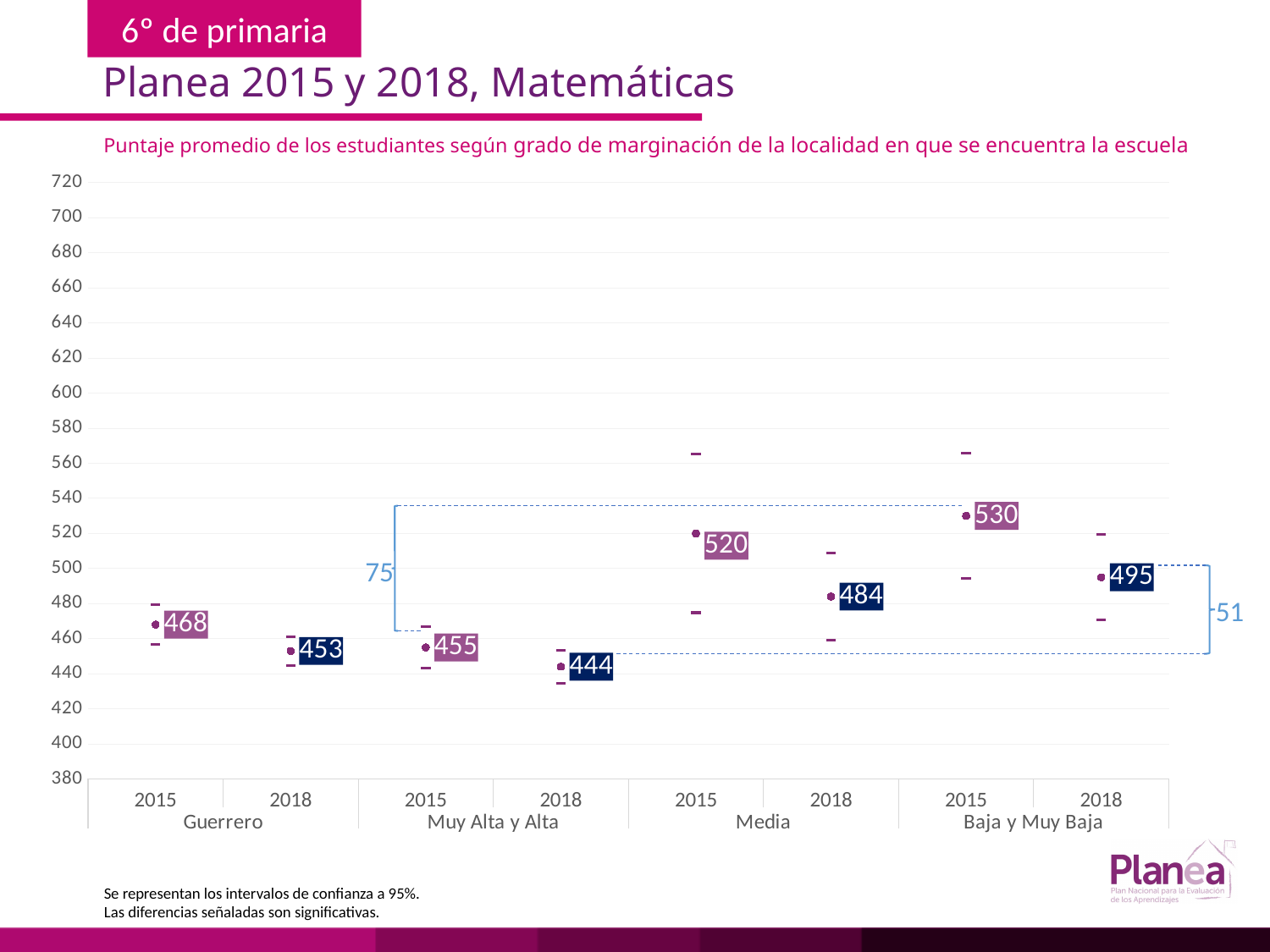
What is the average score for Muy Alta y Alta in 2018? 444 What is the difference between the Media scores in 2015 and 2018? 36 Which group and year has the lowest average score? Muy Alta y Alta, 2018 What difference is indicated by the annotation between the 2015 scores of Muy Alta y Alta and Baja y Muy Baja? 75 Which group and year has the highest average score? Baja y Muy Baja, 2015 What is the difference between the Guerrero scores in 2015 and 2018? 15 What is the average score for the Media marginación group in 2018? 484 Which is larger, the 2018 score for Media or the 2018 score for Baja y Muy Baja? Baja y Muy Baja Is the 2015 score for Media greater or less than 500? greater What is the average score for Baja y Muy Baja in 2015? 530 How many data points are plotted on the chart? 8 What is the average score for Guerrero in 2015? 468